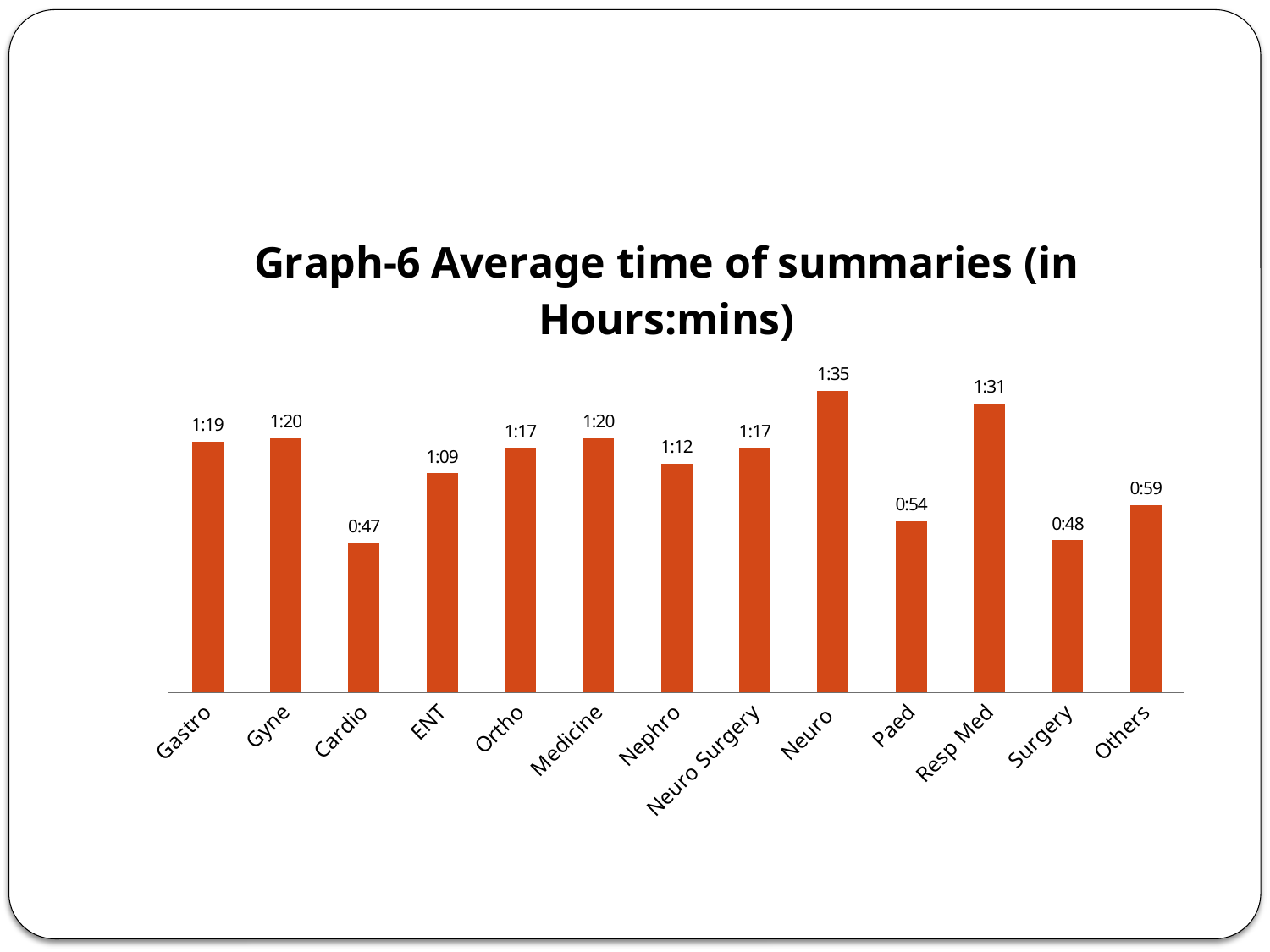
What is the average time of summaries for Neuro? 1:35 What is the average time of summaries for Cardio? 0:47 What is the average time of summaries for Resp Med? 1:31 What is the title of the chart? Graph-6 Average time of summaries (in Hours:mins) What is the difference in average time between Resp Med and Paed? 37 minutes How many categories are shown on the x axis? 13 Which category has the lowest average time of summaries? Cardio Which has a longer average time of summaries, ENT or Nephro? Nephro Which category has the highest average time of summaries? Neuro What kind of chart is shown on the slide? Bar chart What is the average time of summaries for Others? 0:59 What is the difference in average time between Neuro and Cardio? 48 minutes